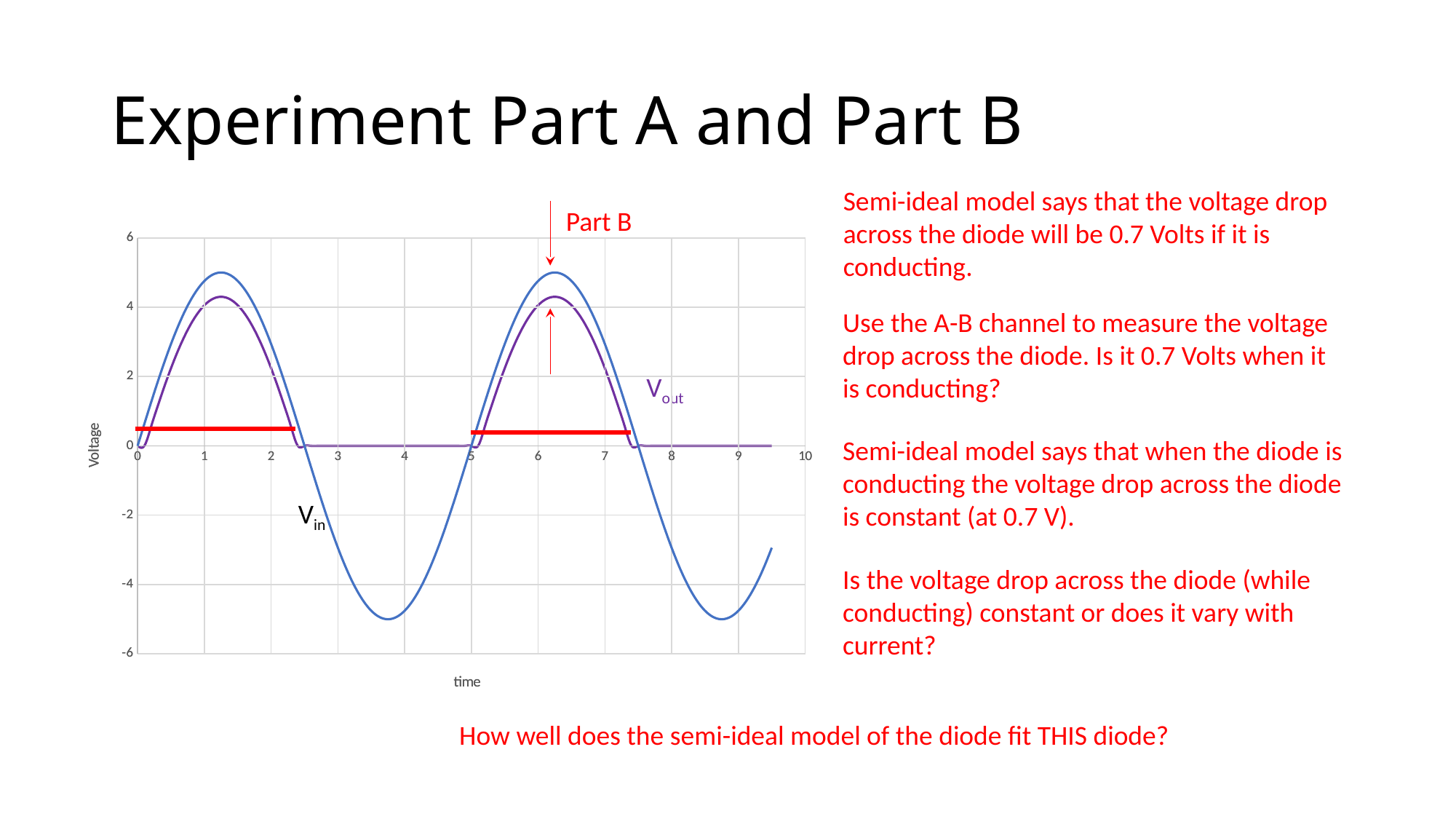
How many series are plotted on the chart? 2 Is the minimum value of Vin greater or less than -4? less What kind of chart is shown on the slide? line chart What is the label of the chart's y axis? Voltage What is the value of Vin at time 5? 0 Between time 1 and time 3, does Vin rise or fall? fall What is the label of the chart's x axis? time How many positive peaks of Vin are shown on the chart? 2 Which series reaches the higher peak voltage, Vin or Vout? Vin Is the peak value of Vout greater or less than 2? greater Is the peak value of Vin greater or less than 4? greater What is the value of Vout at time 4? 0